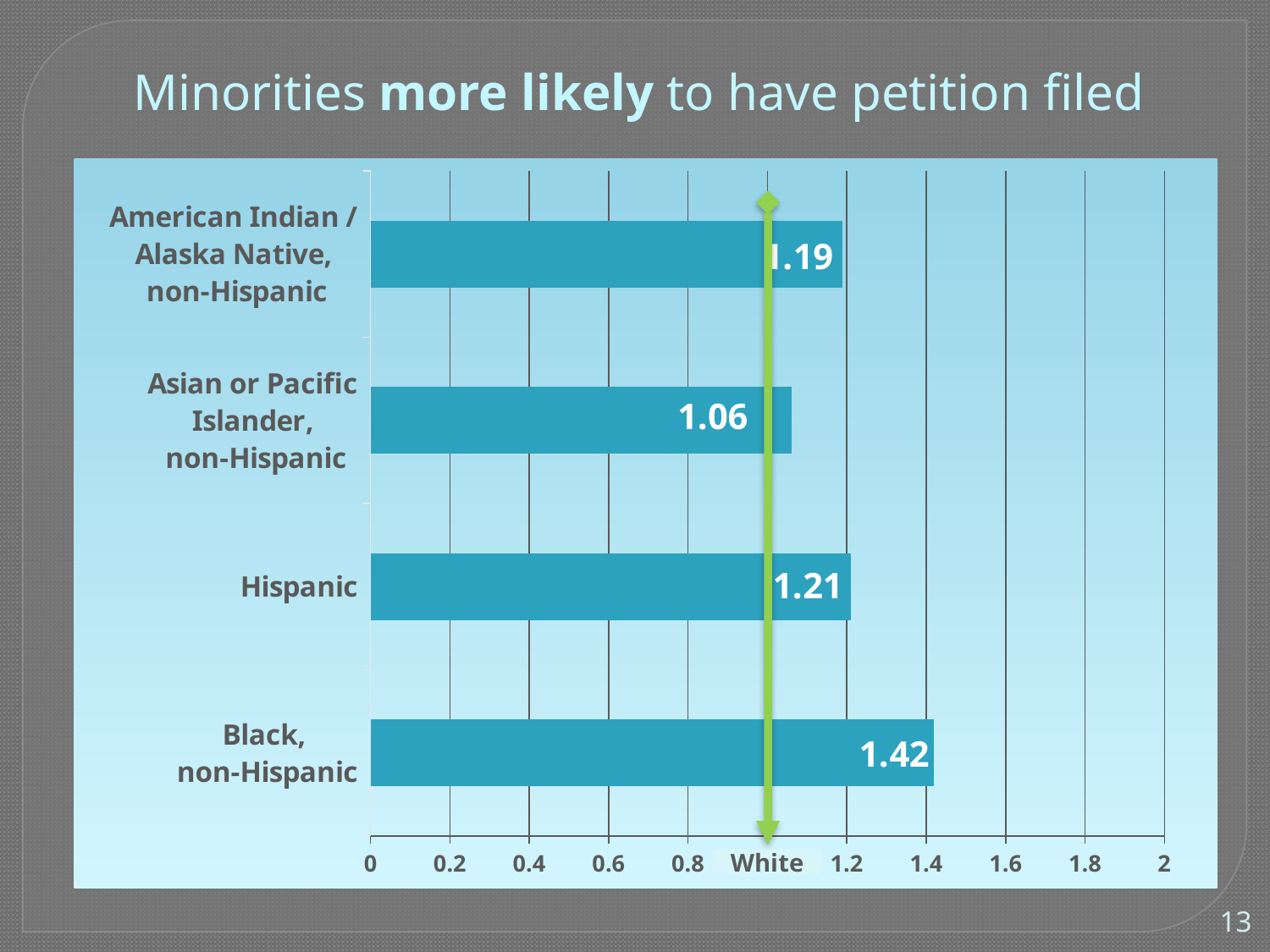
How many categories are shown in the chart? 4 What is the difference between the values for Black, non-Hispanic and Asian or Pacific Islander, non-Hispanic? 0.36 What label is shown on the green vertical reference line in the chart? White What is the value for American Indian / Alaska Native, non-Hispanic? 1.19 Which category has the highest value? Black, non-Hispanic Is the value for Black, non-Hispanic greater or less than 1.2? greater What is the value for Black, non-Hispanic? 1.42 Which category has the lowest value? Asian or Pacific Islander, non-Hispanic What is the value for Asian or Pacific Islander, non-Hispanic? 1.06 What is the value for Hispanic? 1.21 What kind of chart is shown on the slide? Bar chart Which is larger, the value for Hispanic or the value for Asian or Pacific Islander, non-Hispanic? Hispanic